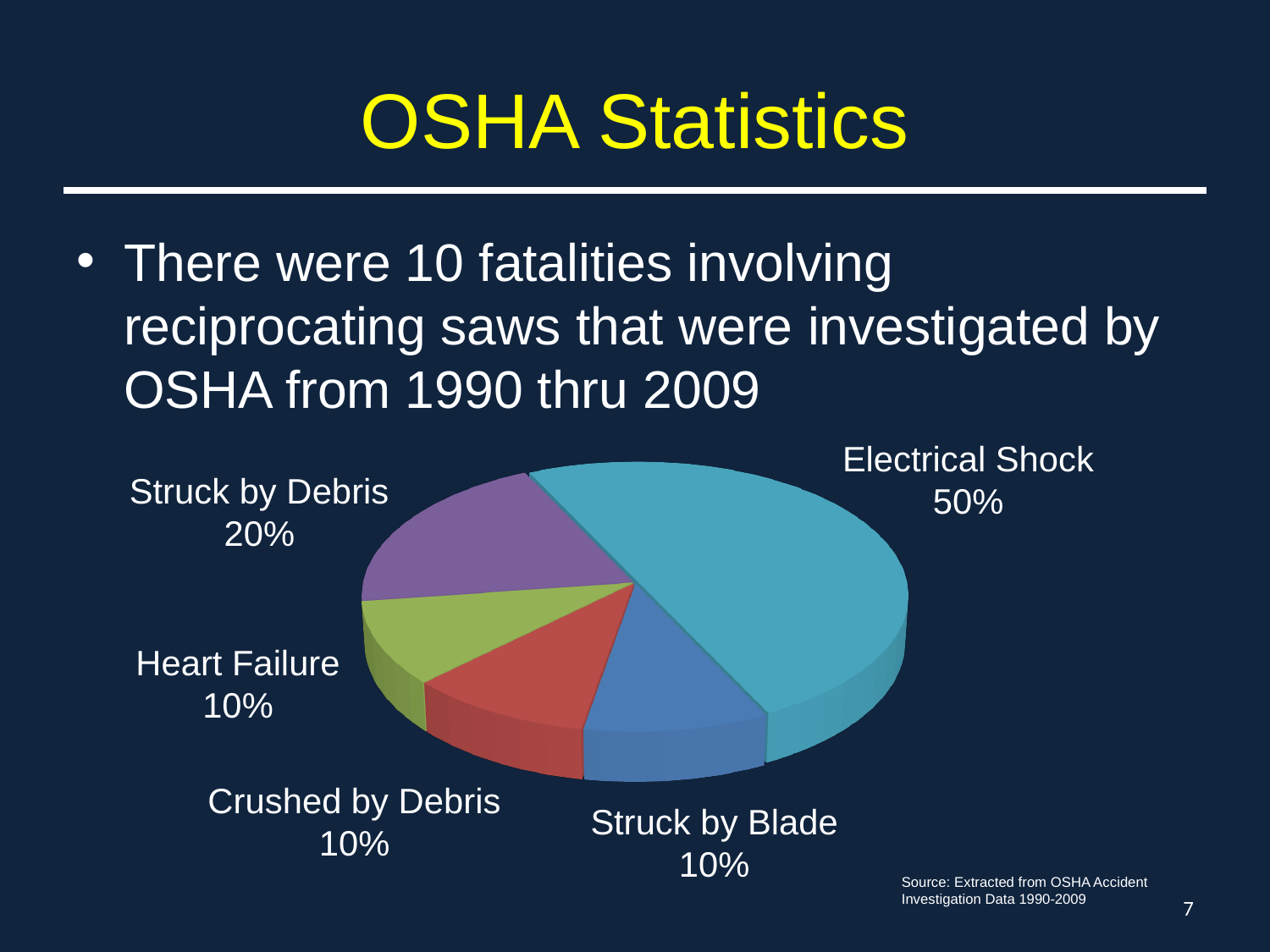
What share of fatalities is attributed to Struck by Debris? 20% What share of fatalities is attributed to Electrical Shock? 50% What is the title of the slide containing the pie chart? OSHA Statistics Which is larger, the share for Struck by Debris or the share for Crushed by Debris? Struck by Debris What is the combined share of Heart Failure, Crushed by Debris and Struck by Blade? 30% What share of fatalities is attributed to Heart Failure? 10% Which category has the largest slice of the pie? Electrical Shock How many categories are shown in the pie chart? 5 What is the difference between the Electrical Shock share and the Struck by Debris share? 30% What kind of chart is shown on the slide? pie chart What colour is the Electrical Shock slice? teal/light blue